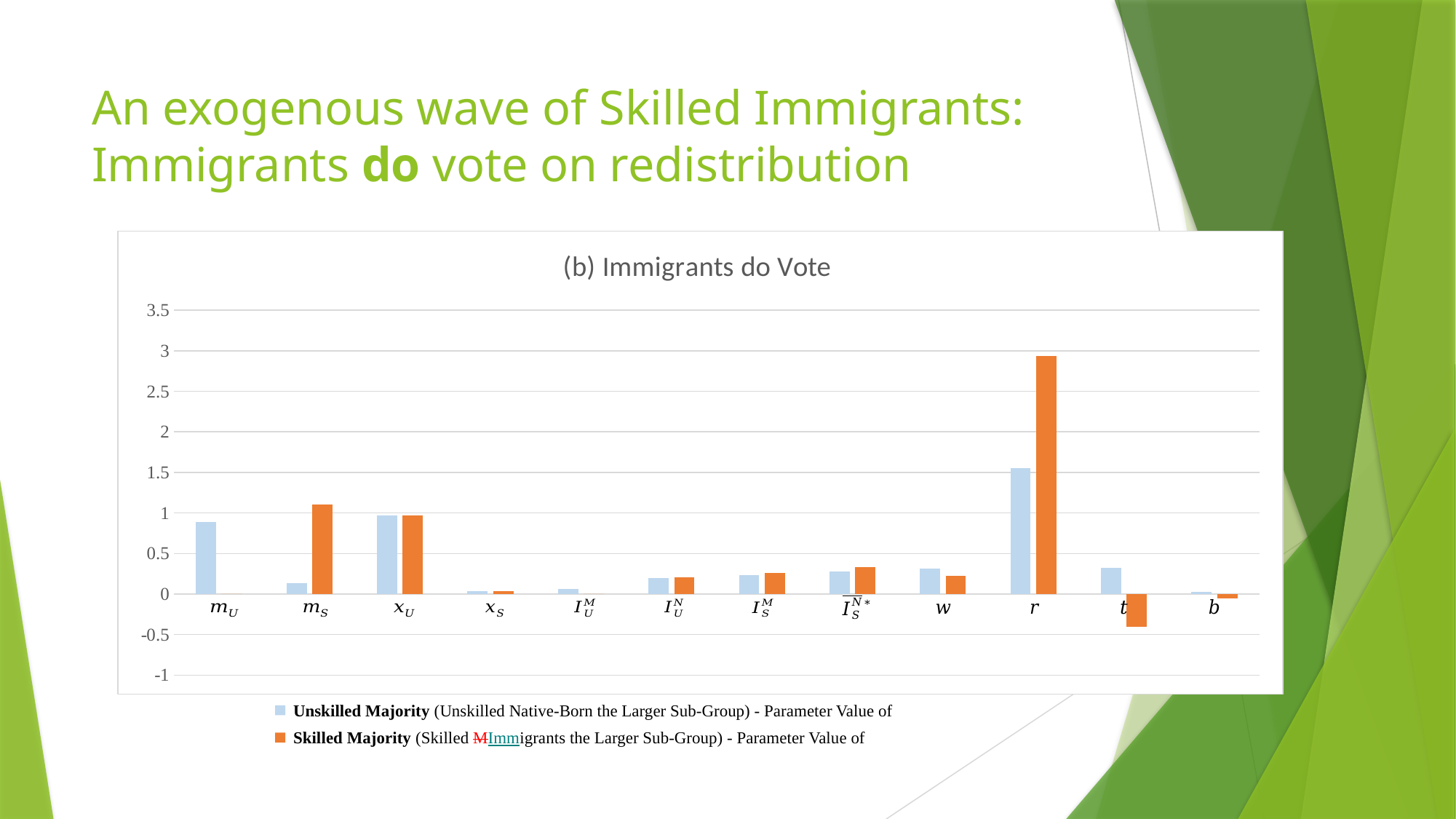
What is the title of the chart? (b) Immigrants do Vote For category t, which series has the larger value, Unskilled Majority or Skilled Majority? Unskilled Majority How many categories are shown along the x axis of the chart? 12 How many series does the chart's legend list? 2 Is the Unskilled Majority value for m_U greater or less than 1? less Which category has the highest Skilled Majority value? r Which category has the highest Unskilled Majority value? r Is the Skilled Majority value for r greater or less than 2.5? greater Is the Skilled Majority value for t greater or less than 0? less What kind of chart is shown on the slide? bar chart For category m_S, which series has the larger value, Unskilled Majority or Skilled Majority? Skilled Majority Which category has the lowest Skilled Majority value? t